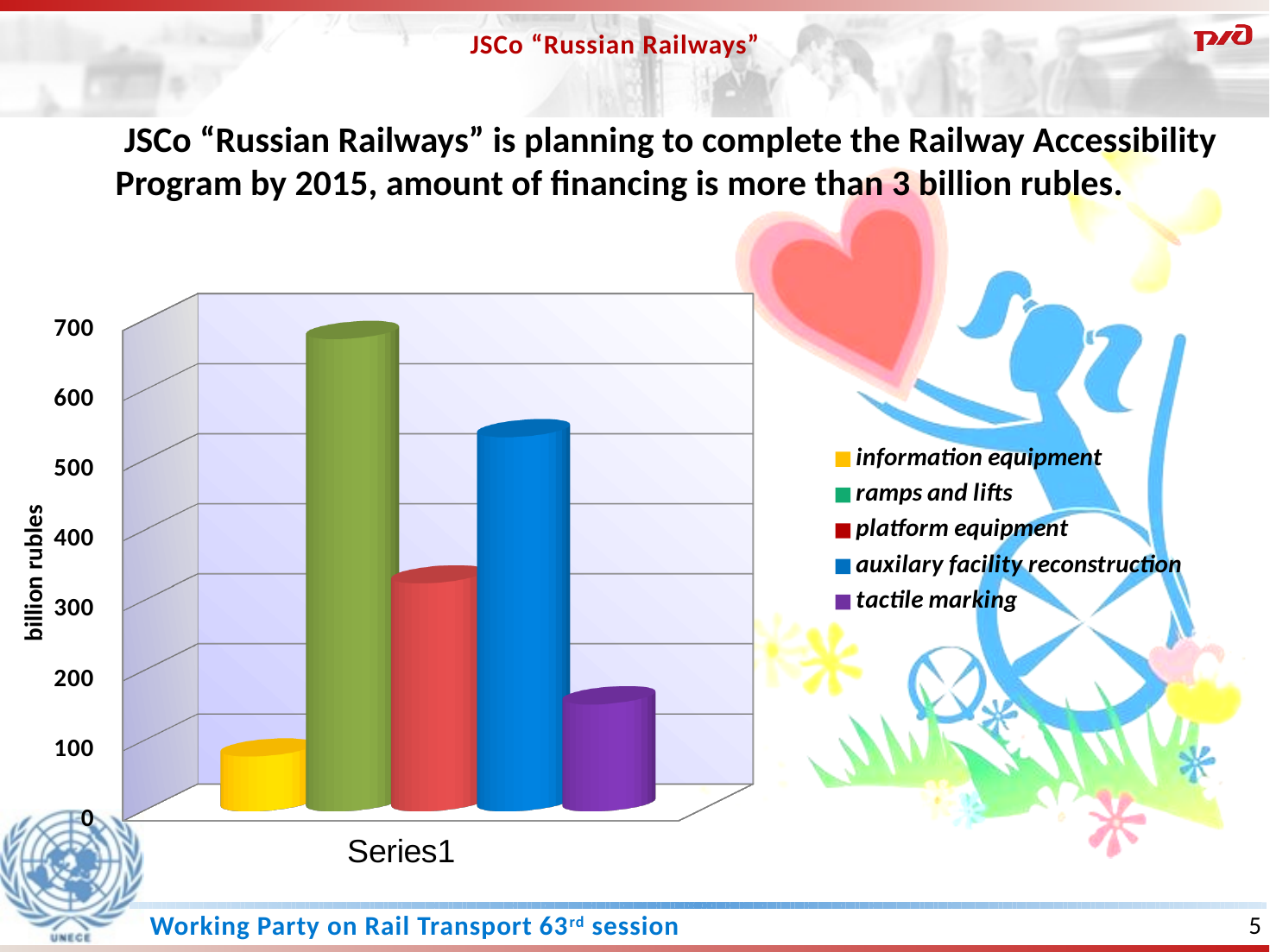
How many series does the legend list? 5 Is the value for information equipment greater or less than 200? less Is the value for auxilary facility reconstruction greater or less than 400? greater Which series has the highest value? ramps and lifts Which series has the lowest value? information equipment What type of chart is shown on the slide? bar chart Which is larger, the value for auxilary facility reconstruction or the value for platform equipment? auxilary facility reconstruction Is the value for tactile marking greater or less than 300? less Which is larger, the value for tactile marking or the value for information equipment? tactile marking What is the label on the vertical axis of the chart? billion rubles